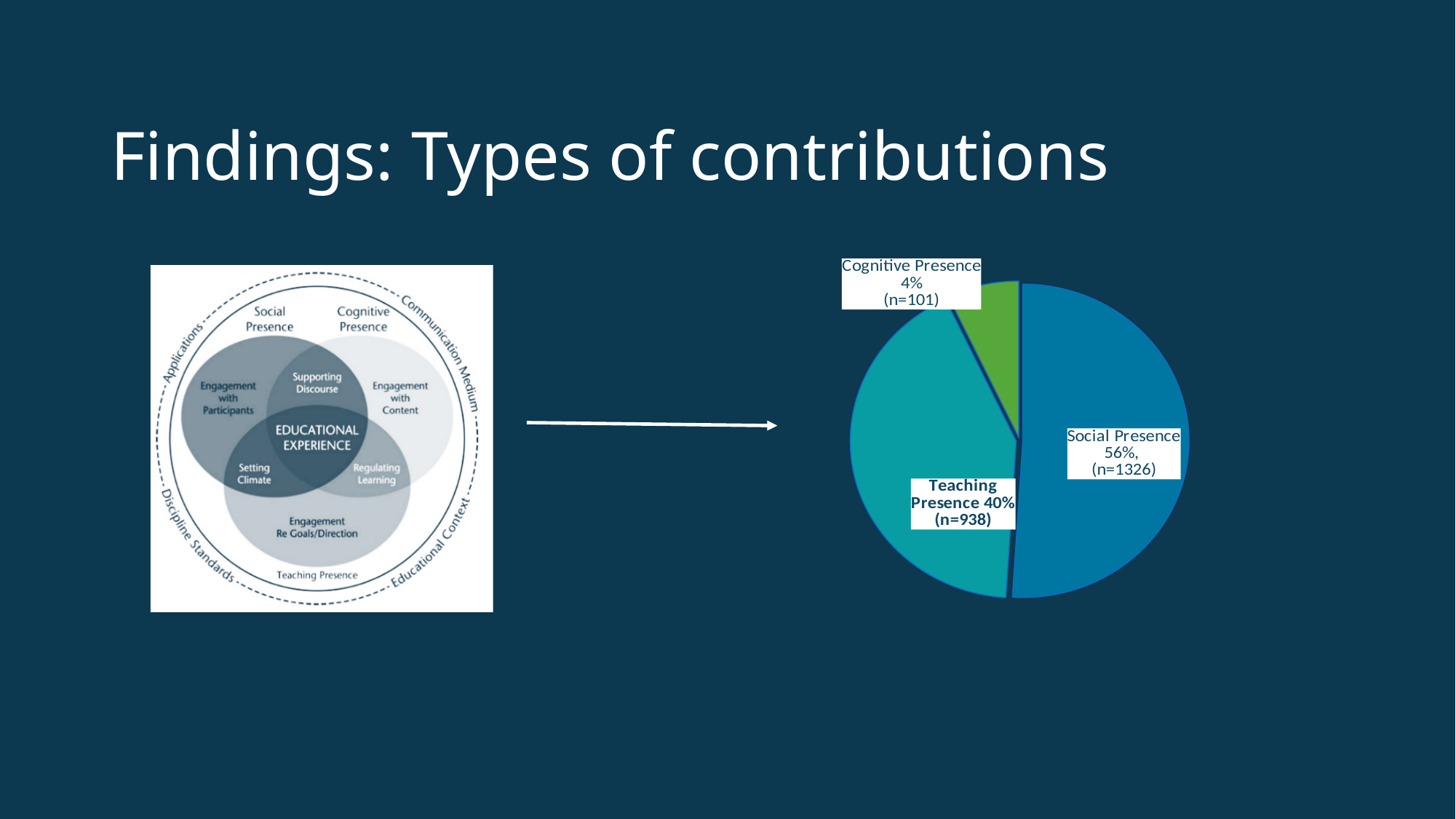
What percentage of contributions does the pie chart show for Social Presence? 56% Which category has the largest slice in the pie chart? Social Presence What percentage of contributions does the pie chart show for Cognitive Presence? 4% What is the difference in percentage points between Social Presence and Teaching Presence in the pie chart? 16 What percentage of contributions does the pie chart show for Teaching Presence? 40% How many slices does the pie chart have? 3 What kind of chart is shown on the right of the slide? pie chart How many contributions (n) are shown for Teaching Presence in the pie chart? 938 Which category has the smallest slice in the pie chart? Cognitive Presence Which is larger in the pie chart, Teaching Presence or Cognitive Presence? Teaching Presence How many contributions (n) are shown for Social Presence in the pie chart? 1326 How many contributions (n) are shown for Cognitive Presence in the pie chart? 101